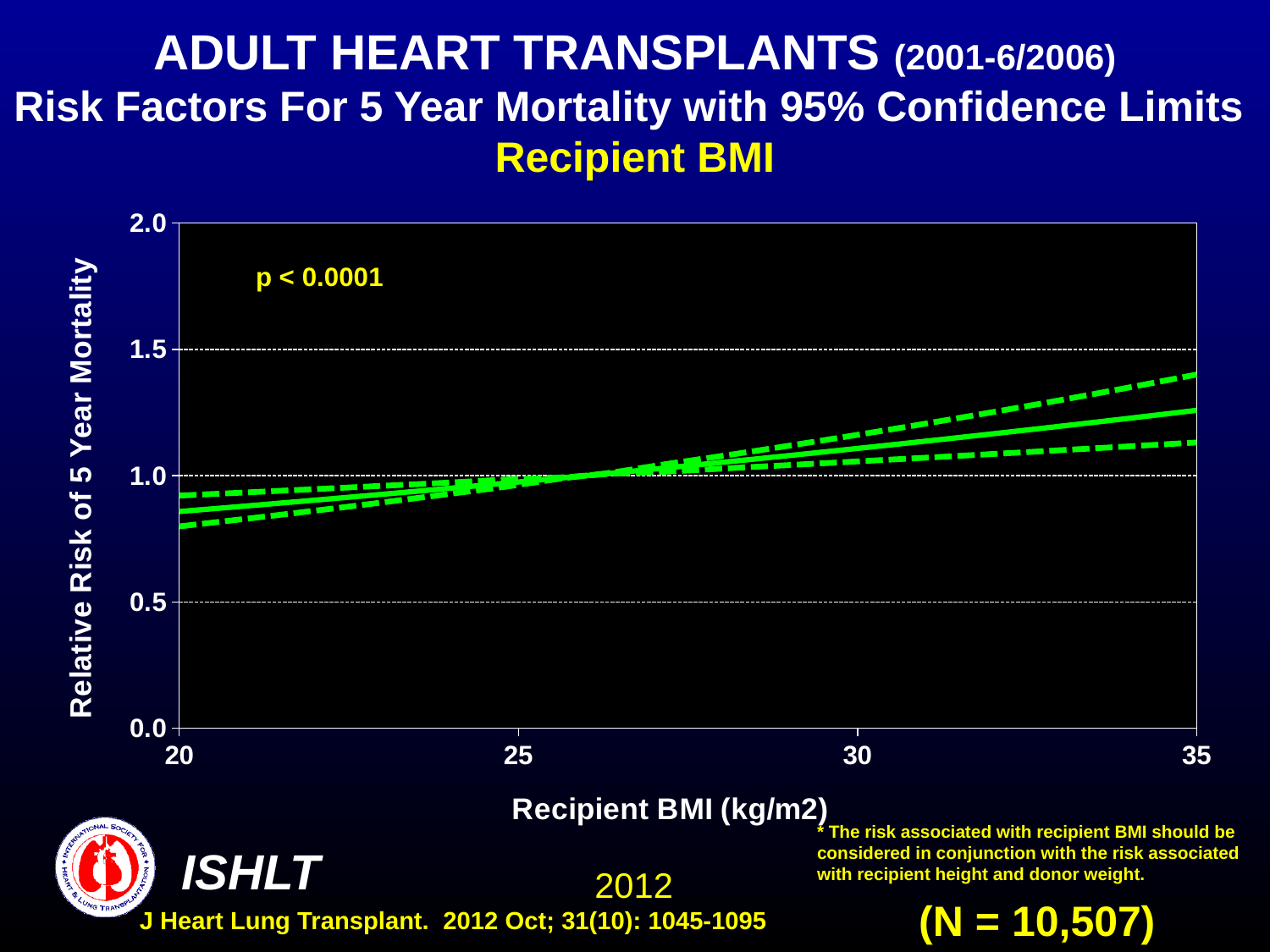
Is the relative risk at a recipient BMI of 35 larger or smaller than the relative risk at a recipient BMI of 20? larger Is the relative risk of 5 year mortality at a recipient BMI of 35 greater or less than 1.0? greater Is the relative risk of 5 year mortality at a recipient BMI of 20 greater or less than 1.0? less What is the sample size N shown on the slide? N = 10,507 Is the relative risk of 5 year mortality at a recipient BMI of 35 greater or less than 1.5? less How many lines are plotted on the chart? 3 Does the relative risk of 5 year mortality rise or fall as recipient BMI increases from 20 to 35? rise What kind of chart is shown on the slide? line chart What p-value is shown on the chart? p < 0.0001